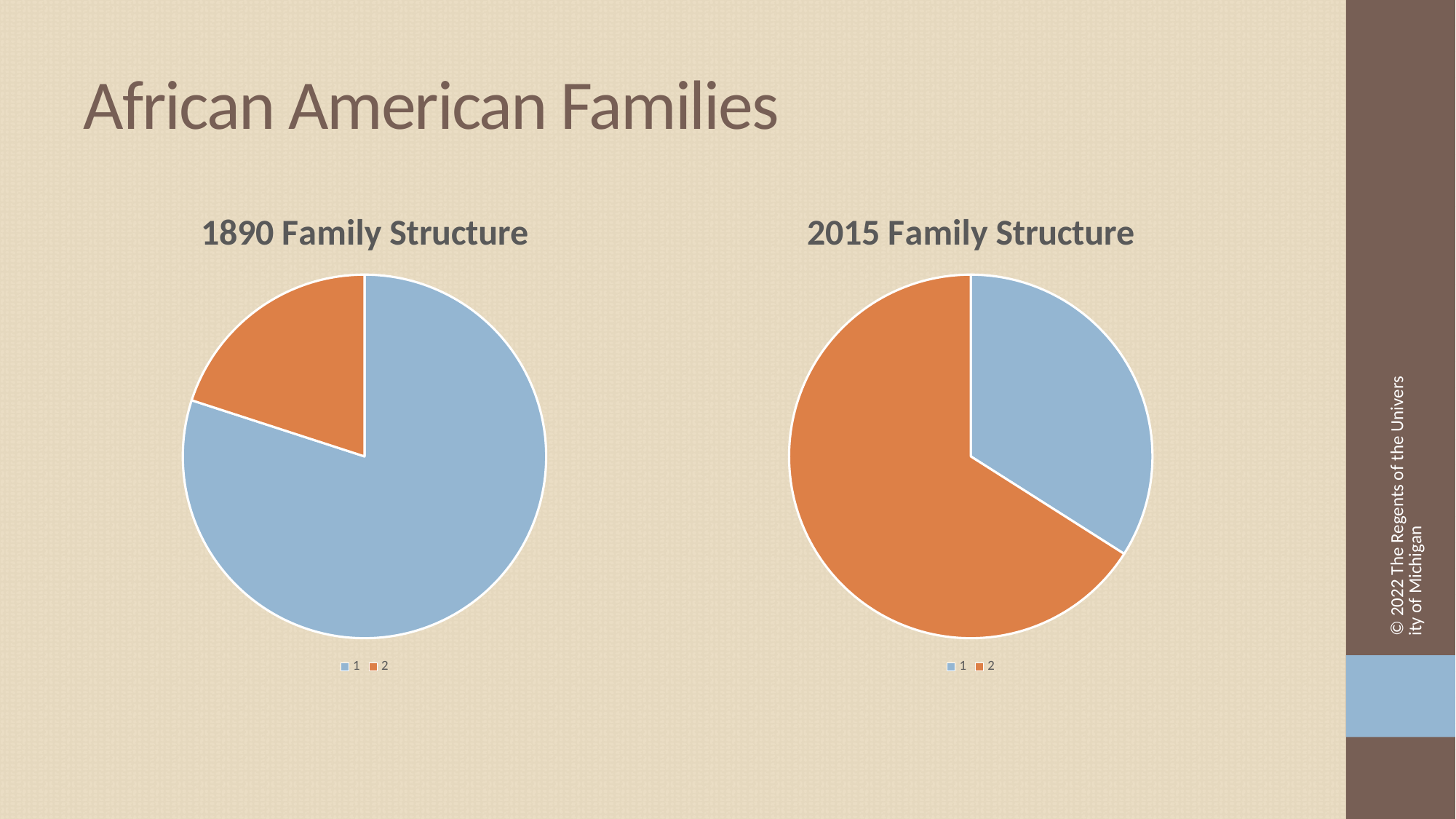
What is the title of the pie chart on the left of the slide? 1890 Family Structure In the "1890 Family Structure" chart, which category has the smallest slice? 2 How many entries does the legend of the "1890 Family Structure" chart list? 2 How many slices does the "1890 Family Structure" pie chart have? 2 What kind of chart is the "2015 Family Structure" chart? pie chart How many slices does the "2015 Family Structure" pie chart have? 2 What kind of chart is the "1890 Family Structure" chart? pie chart In the "2015 Family Structure" chart, which category has the largest slice? 2 What colour is the slice for category 2 in the "2015 Family Structure" chart? orange In the "2015 Family Structure" chart, which category has the smallest slice? 1 In the "2015 Family Structure" chart, which slice is larger, category 1 or category 2? 2 In the "1890 Family Structure" chart, which category has the largest slice? 1